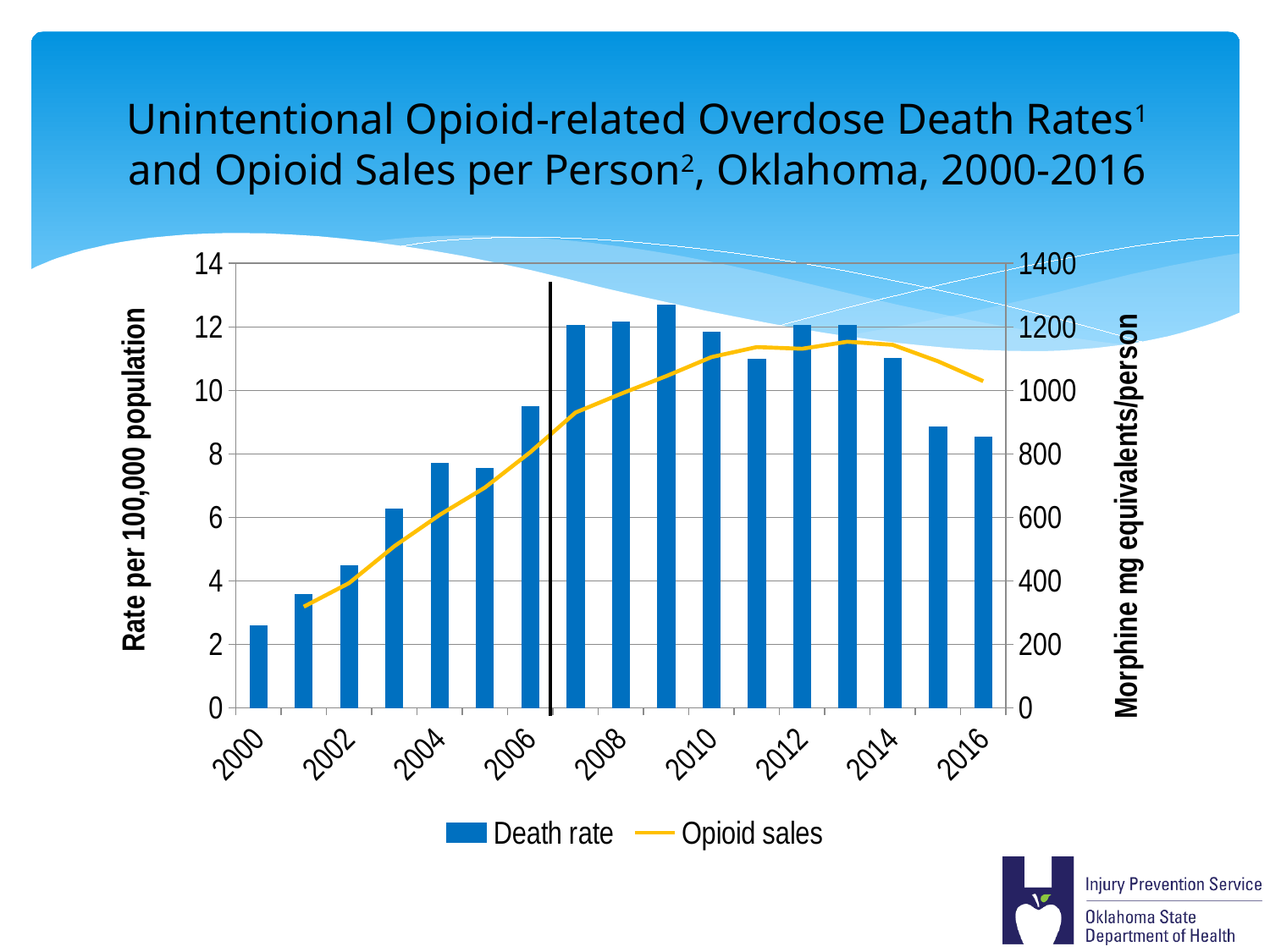
Is the opioid sales value for 2001 greater or less than 400? less Is the death rate for 2016 greater or less than 8? greater How many series does the legend list? 2 Which year has the highest death rate? 2009 Which year has the lowest death rate? 2000 Which year has the larger death rate, 2004 or 2008? 2008 Does the death rate rise or fall from 2000 to 2009? rise Is the death rate for 2000 greater or less than 4? less What is the title of the left vertical axis? Rate per 100,000 population How many years (bars) are plotted for the death rate? 17 What are the two series named in the legend? Death rate and Opioid sales